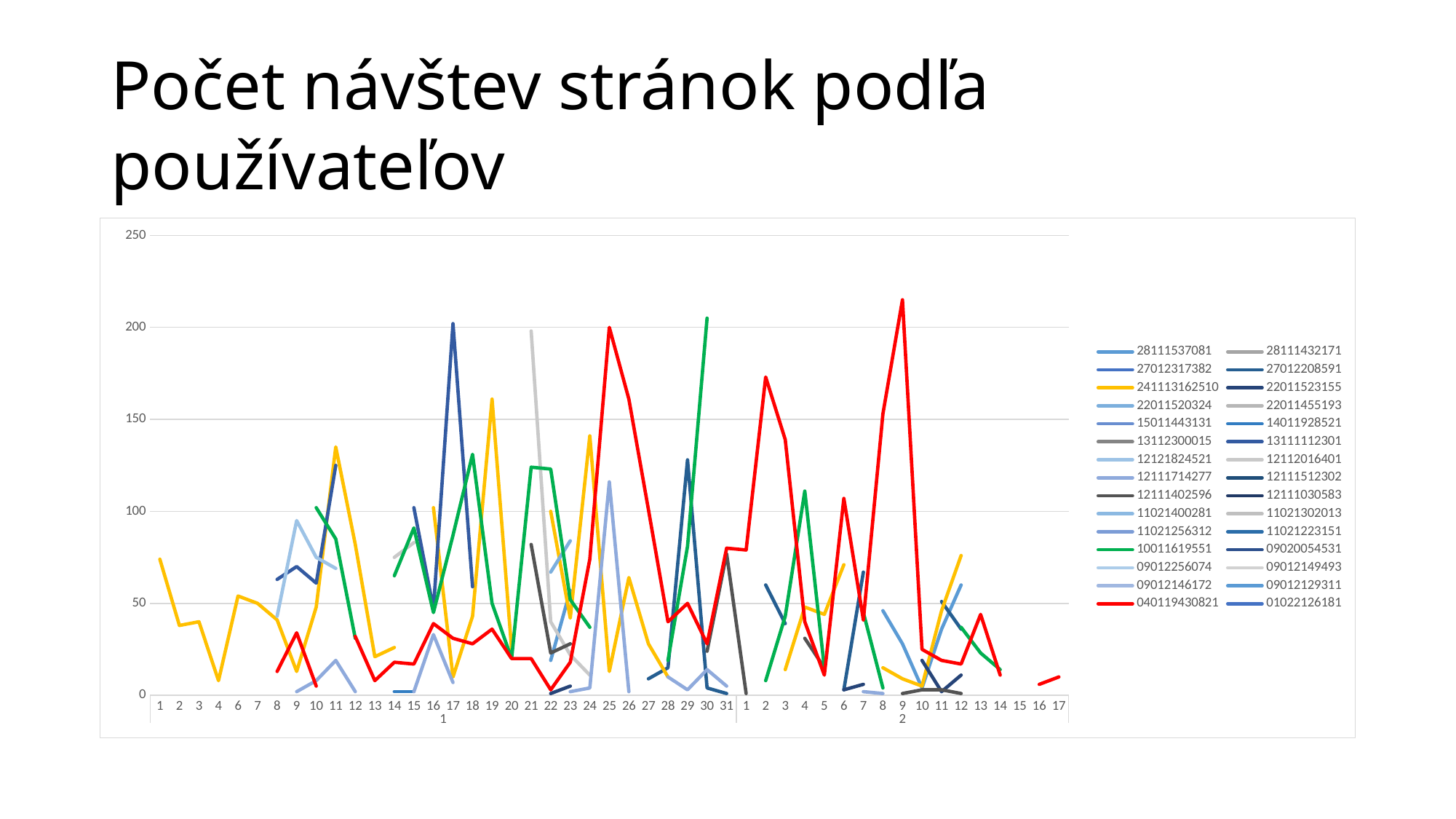
What kind of chart is shown on the slide? line chart Does the red series 040119430821 rise or fall between day 9 and day 10 of month 2? fall What is the title of the slide above the chart? Počet návštev stránok podľa používateľov Which is larger for the yellow series 241113162510: the value on day 19 of month 1 or the value on day 4 of month 1? day 19 of month 1 Is the value of the green series 10011619551 on day 30 of month 1 greater or less than 150? greater Is the value of the red series 040119430821 on day 2 of month 2 greater or less than 150? greater Which is larger for the red series 040119430821: the value on day 9 of month 2 or the value on day 16 of month 2? day 9 of month 2 What is the highest value shown on the vertical axis? 250 Is the value of the yellow series 241113162510 on day 1 of month 1 greater or less than 100? less How many series does the legend list? 30